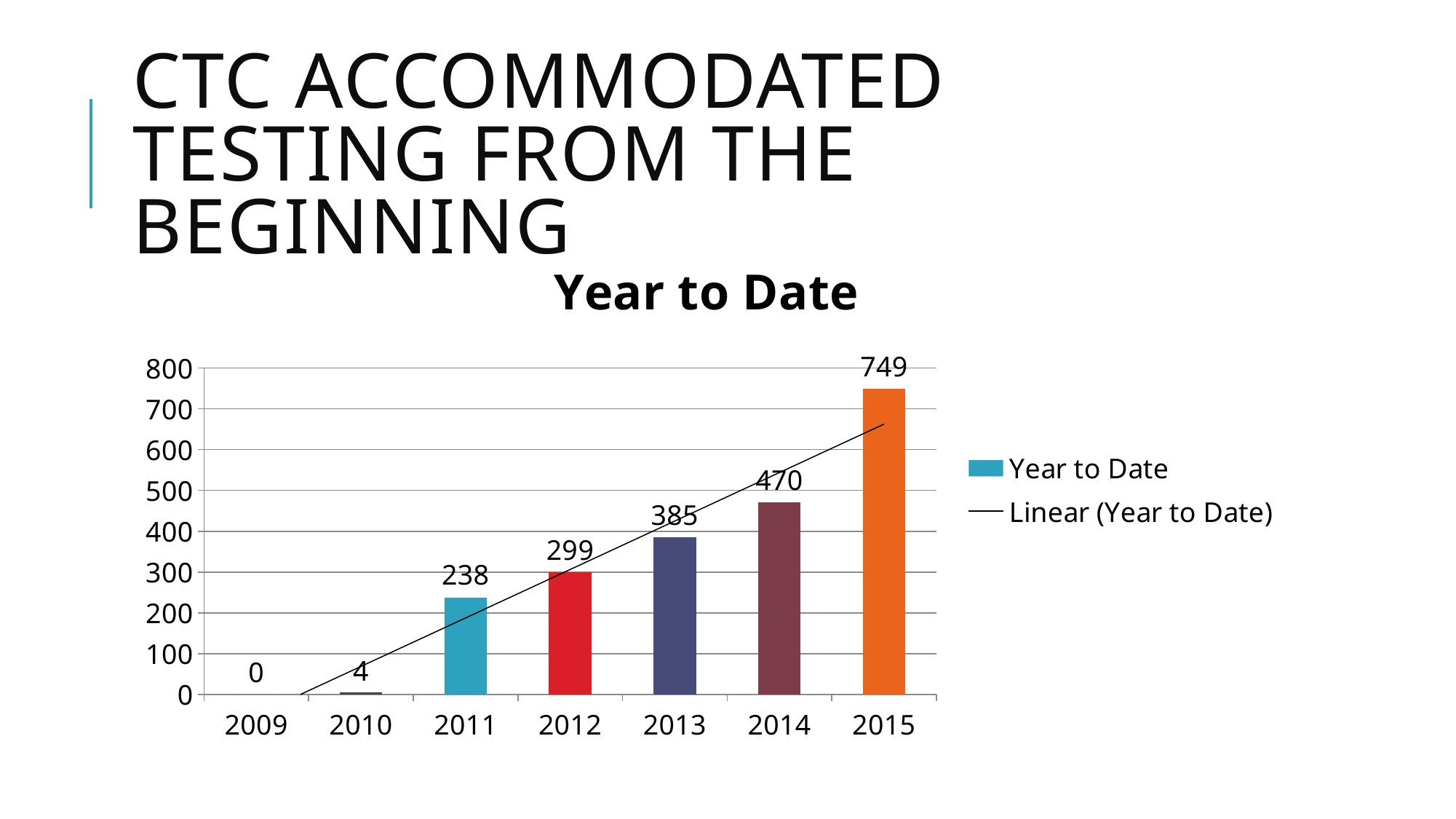
What is the Year to Date value for 2012? 299 How many entries does the legend list? 2 What kind of chart is shown? Bar chart Which year has the highest Year to Date value? 2015 What is the Year to Date value for 2010? 4 How many years are shown on the x axis? 7 What is the Year to Date value for 2015? 749 What is the difference between the Year to Date values for 2015 and 2014? 279 What is the difference between the Year to Date values for 2013 and 2012? 86 Do the Year to Date values rise or fall from 2009 to 2015? Rise Which year has the lowest Year to Date value? 2009 Which is larger, the Year to Date value for 2011 or for 2013? 2013